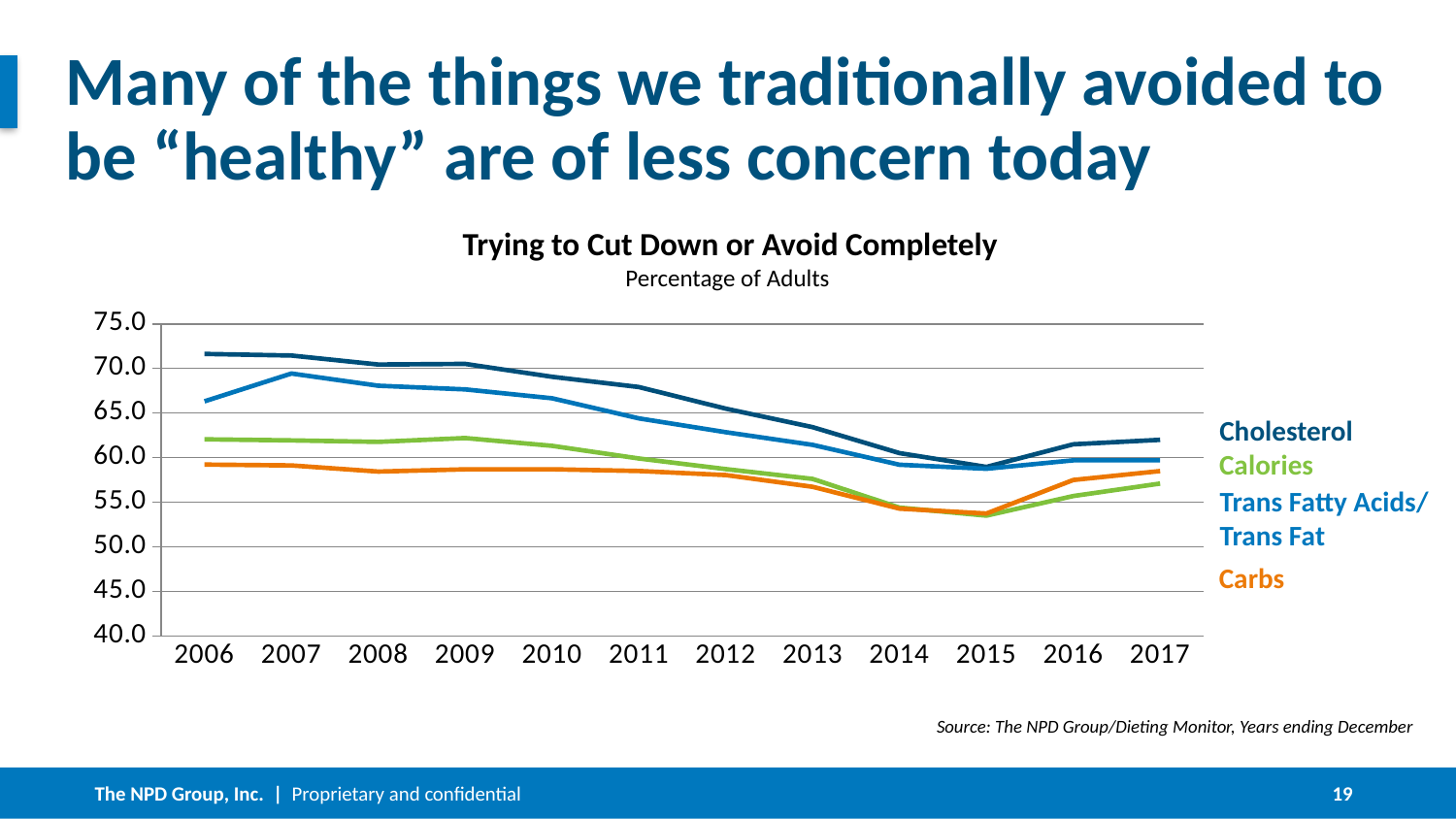
Is the value for Trans Fatty Acids/Trans Fat in 2006 greater or less than 65.0? greater Is the value for Cholesterol in 2006 greater or less than 70.0? greater What kind of chart is shown on the slide? Line chart Is the value for Carbs in 2015 greater or less than 55.0? less In 2006, which is larger: the value for Calories or the value for Trans Fatty Acids/Trans Fat? Trans Fatty Acids/Trans Fat Which series has the highest value in 2006? Cholesterol Which series has the lowest value in 2006? Carbs How many years are shown along the x axis of the chart? 12 How many series does the chart's legend list? 4 Does the Carbs line rise or fall from 2006 to 2015? Fall What is the title of the chart? Trying to Cut Down or Avoid Completely In 2010, which is larger: the value for Cholesterol or the value for Carbs? Cholesterol